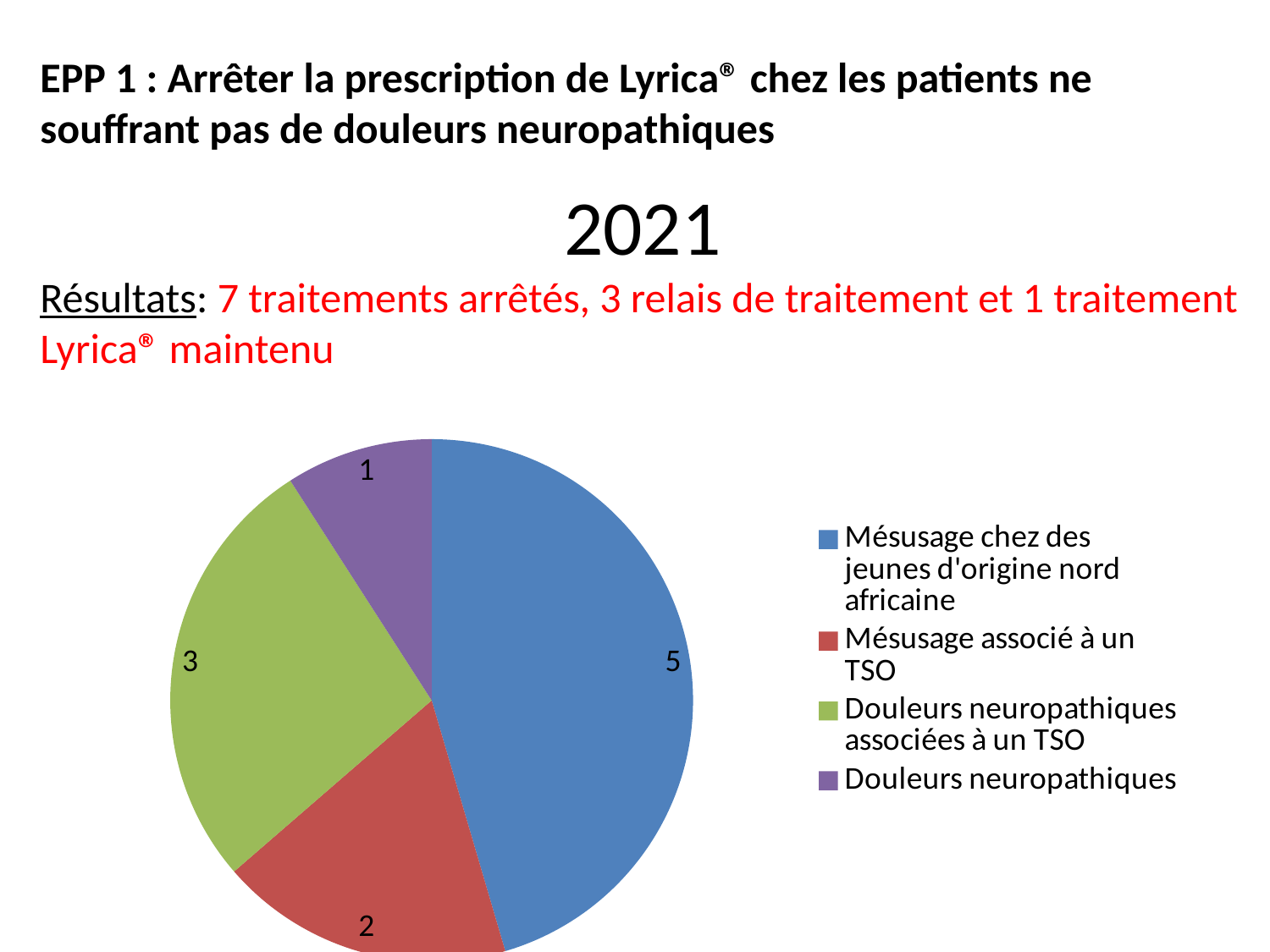
What kind of chart is shown on the slide? pie chart What is the difference between the values for "Mésusage chez des jeunes d'origine nord africaine" and "Douleurs neuropathiques associées à un TSO"? 2 How many slices does the pie chart have? 4 What is the total of all slices in the pie chart? 11 What is the value for "Douleurs neuropathiques"? 1 What is the value for "Douleurs neuropathiques associées à un TSO"? 3 Which category has the smallest slice? Douleurs neuropathiques What is the value for "Mésusage associé à un TSO"? 2 What is the value for "Mésusage chez des jeunes d'origine nord africaine"? 5 What colour is the slice for "Douleurs neuropathiques associées à un TSO"? green Which category has the largest slice? Mésusage chez des jeunes d'origine nord africaine Which is larger: "Douleurs neuropathiques associées à un TSO" or "Mésusage associé à un TSO"? Douleurs neuropathiques associées à un TSO